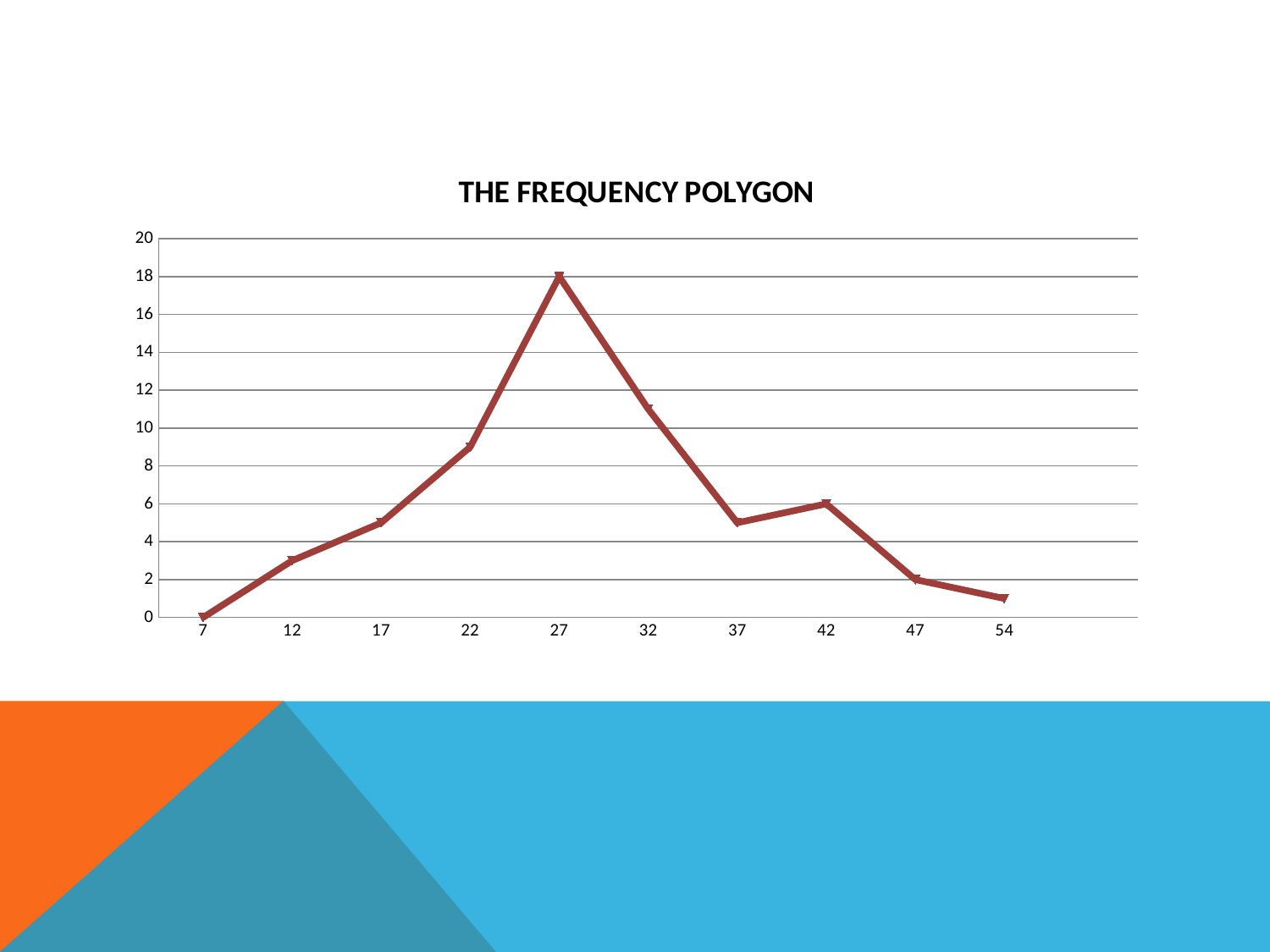
At which x value does the line reach its highest point? 27 What is the value at x = 27? 18 Is the value at x = 32 greater or less than 10? greater What is the value at x = 42? 6 Which has the larger value, x = 22 or x = 37? 22 How many data points are plotted on the line? 10 What is the difference between the values at x = 27 and x = 42? 12 What is the value at x = 47? 2 What type of chart is shown on the slide? Line chart At which x value does the line have its lowest value? 7 Do the values rise or fall along the x axis from 27 to 54? Fall What is the title of the chart? THE FREQUENCY POLYGON